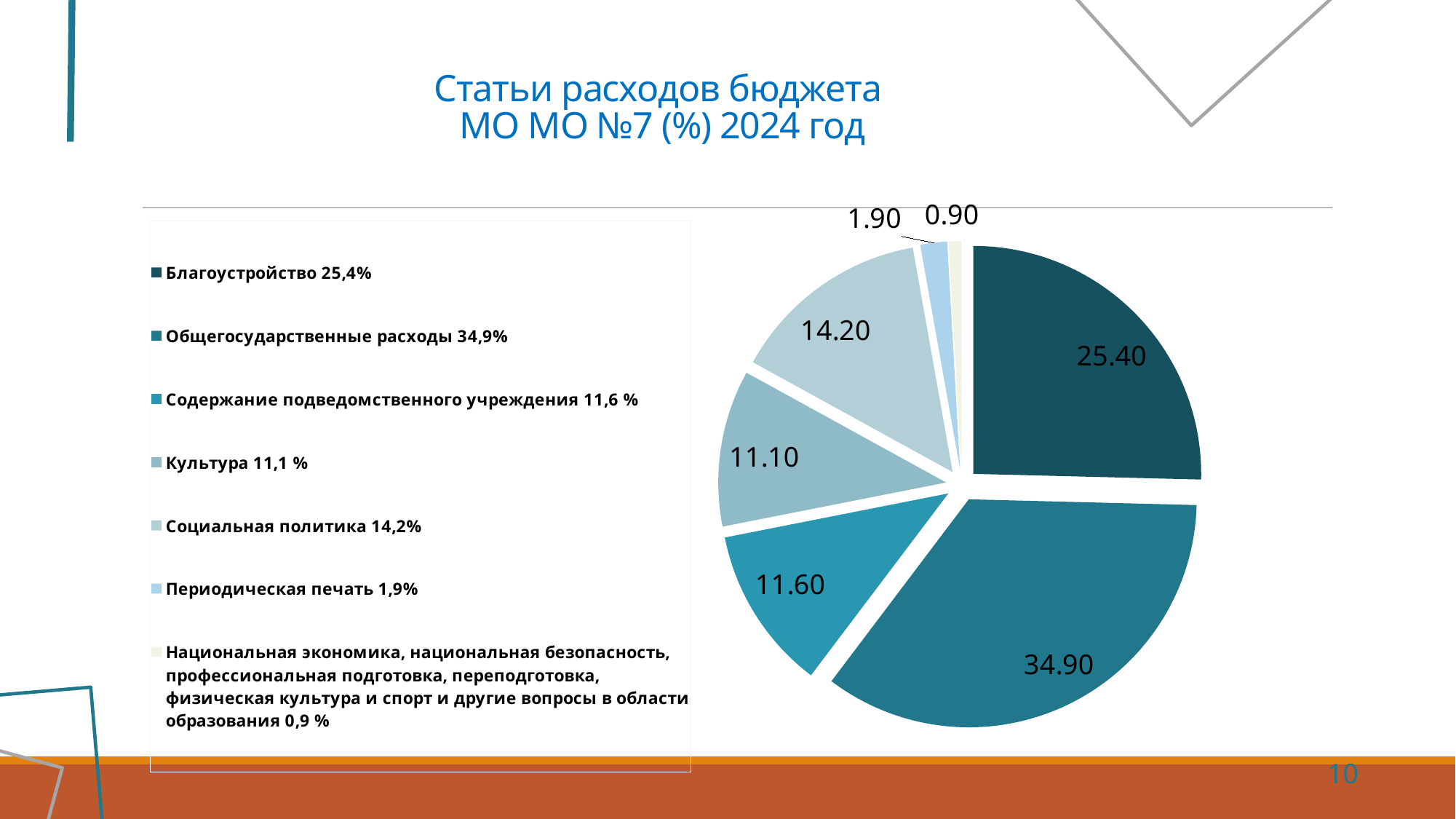
What is the data label for the Общегосударственные расходы slice? 34.90 What is the data label for the Периодическая печать slice? 1.90 Which category has the largest slice of the pie? Общегосударственные расходы What type of chart is shown on the slide? pie chart What is the data label for the Благоустройство slice? 25.40 How many entries does the legend list? 7 What is the title of the slide containing the chart? Статьи расходов бюджета МО МО №7 (%) 2024 год What is the difference between the Общегосударственные расходы slice (34.90) and the Благоустройство slice (25.40)? 9.50 Which slice is larger: Содержание подведомственного учреждения or Социальная политика? Социальная политика How many slices does the pie chart have? 7 What is the data label for the Социальная политика slice? 14.20 Which category has the smallest slice of the pie? Национальная экономика, национальная безопасность, профессиональная подготовка, переподготовка, физическая культура и спорт и другие вопросы в области образования